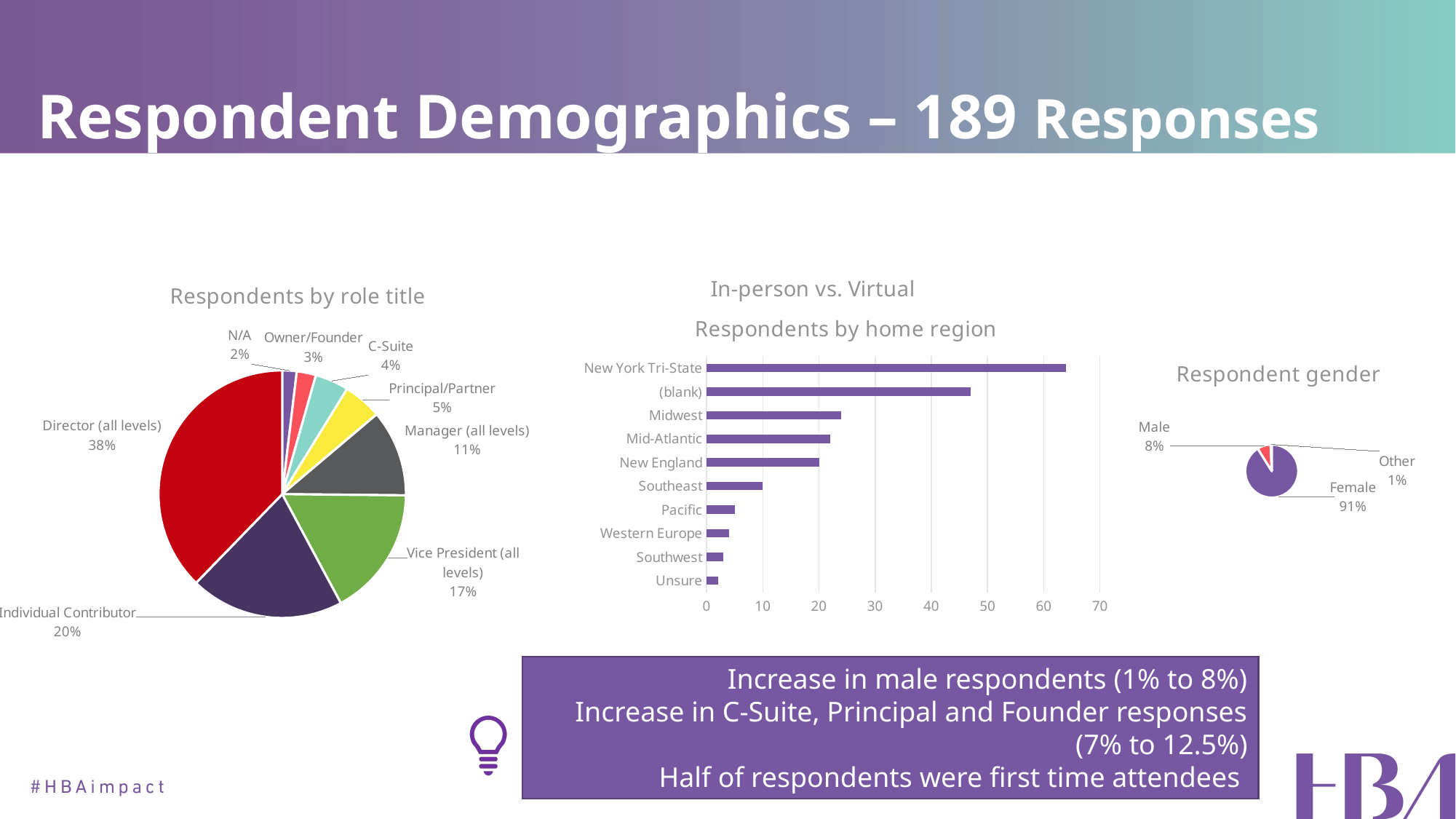
In the 'Respondents by role title' pie chart, which is larger: Manager (all levels) or Principal/Partner? Manager (all levels) What type of chart is the 'Respondents by home region' chart? Bar chart In the 'Respondents by role title' pie chart, what is the difference between the Director (all levels) share and the Individual Contributor share? 18% In the 'Respondent gender' pie chart, what share of respondents are Female? 91% In the 'Respondents by home region' chart, which region has the highest value? New York Tri-State In the 'Respondents by role title' pie chart, what share of respondents are Vice President (all levels)? 17% In the 'Respondents by home region' chart, is the value for New York Tri-State greater or less than 60? greater In the 'Respondents by role title' pie chart, what share of respondents are Director (all levels)? 38% In the 'Respondents by role title' pie chart, which role title has the smallest share? N/A In the 'Respondents by home region' chart, how many region categories are listed? 10 In the 'Respondents by home region' chart, is the value for Pacific greater or less than 10? less In the 'Respondents by role title' pie chart, how many role title categories are shown? 8